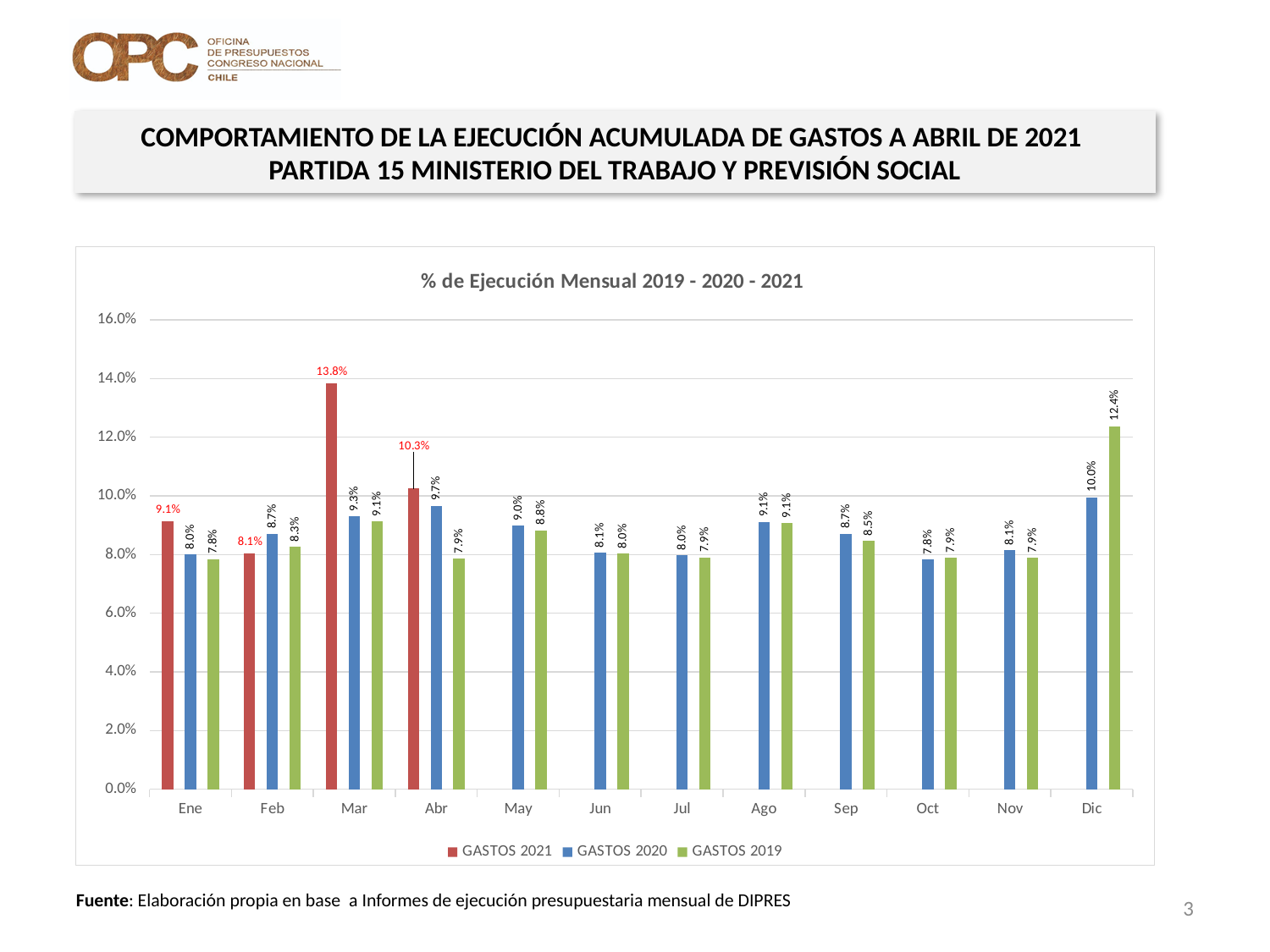
How many months are shown on the x axis? 12 Which colour represents GASTOS 2019 in the chart? Green How many series does the legend list? 3 What is the difference between GASTOS 2021 and GASTOS 2020 in Mar? 4.5% What is the value for GASTOS 2019 in Dic? 12.4% What is the title of the chart? % de Ejecución Mensual 2019 - 2020 - 2021 In which month is the GASTOS 2021 value lowest? Feb In which month is the GASTOS 2020 value highest? Dic Which is larger in Feb, GASTOS 2020 or GASTOS 2021? GASTOS 2020 What kind of chart is shown? Bar chart What is the value for GASTOS 2021 in Mar? 13.8% What is the value for GASTOS 2020 in Abr? 9.7%